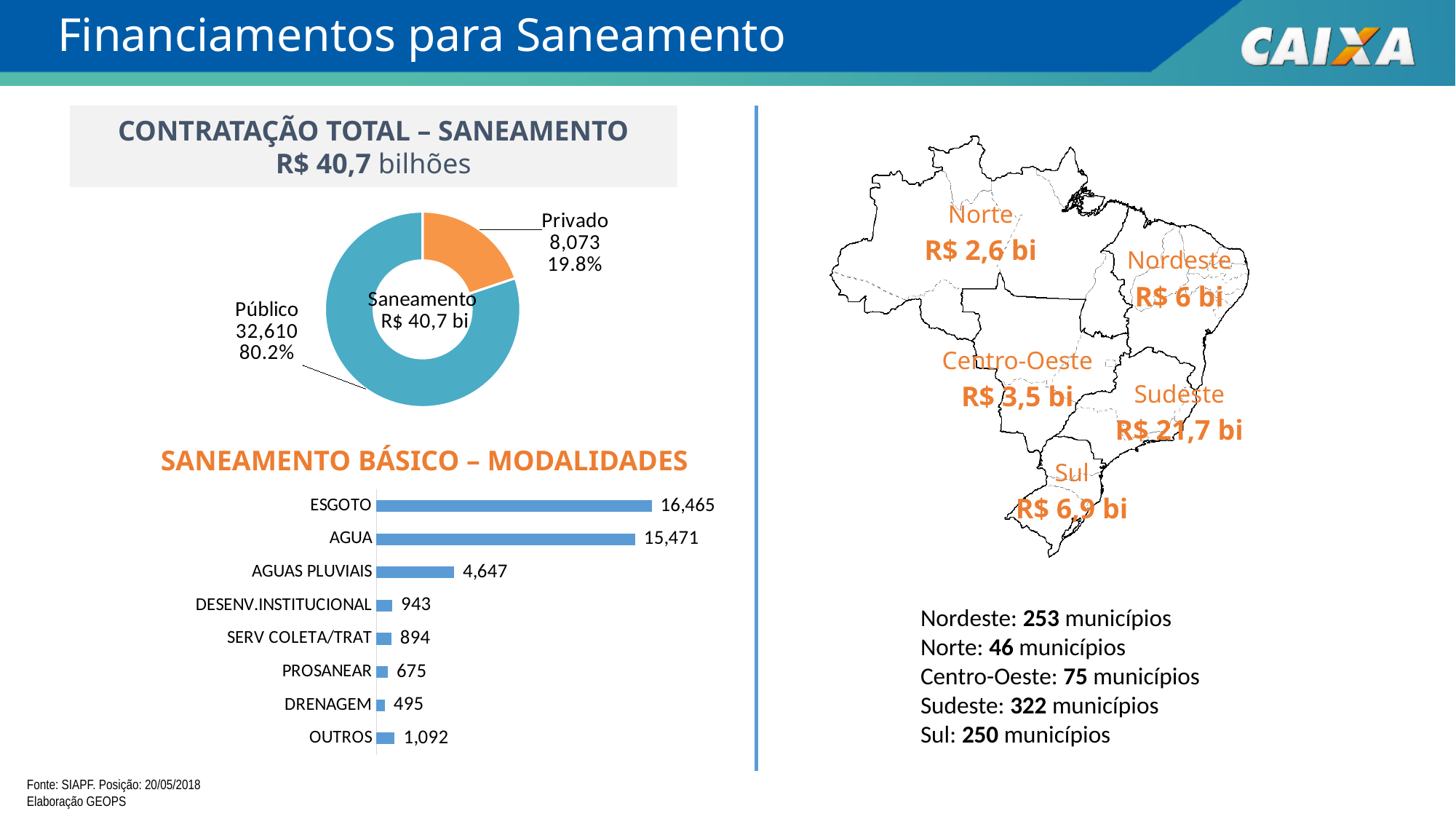
In the Saneamento Básico – Modalidades bar chart, which category has the lowest value? DRENAGEM What kind of chart is Saneamento Básico – Modalidades? Bar chart What kind of chart is the one showing Público and Privado? Donut (pie) chart In the Saneamento Básico – Modalidades bar chart, what is the difference between ESGOTO and AGUA? 994 In the Saneamento Básico – Modalidades bar chart, what is the value for AGUAS PLUVIAIS? 4,647 In the donut chart, what is the difference between the Público and Privado values? 24,537 How many categories are shown in the Saneamento Básico – Modalidades bar chart? 8 What total value is shown in the centre of the donut chart? R$ 40,7 bi In the Saneamento Básico – Modalidades bar chart, which is larger: DESENV.INSTITUCIONAL or SERV COLETA/TRAT? DESENV.INSTITUCIONAL In the Saneamento Básico – Modalidades bar chart, which category has the highest value? ESGOTO In the donut chart, what share does Privado have? 19.8% In the donut chart, what value is shown for Público? 32,610